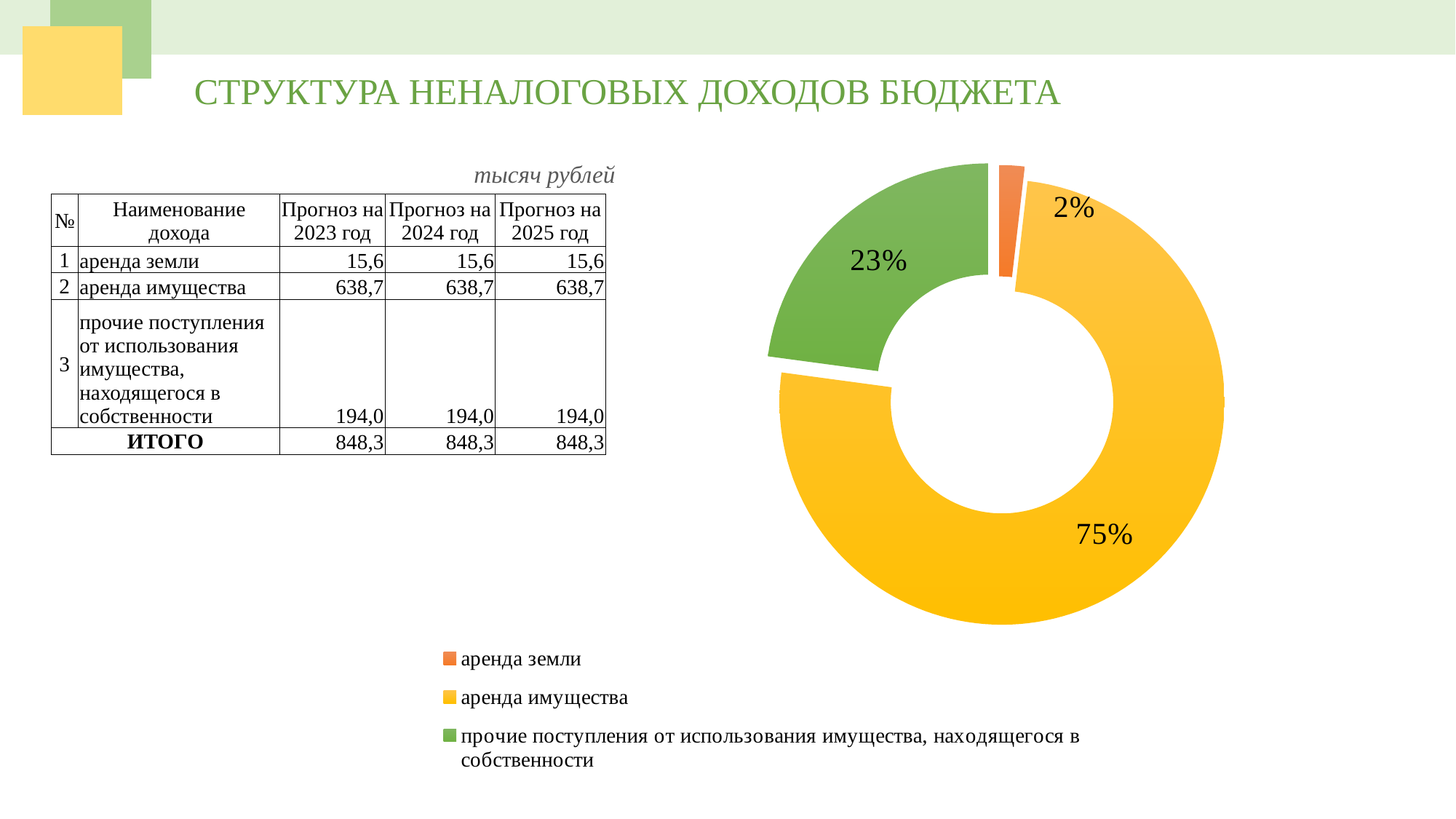
Which slice is larger: "аренда земли" or "прочие поступления от использования имущества, находящегося в собственности"? прочие поступления от использования имущества, находящегося в собственности What share of the doughnut chart does "аренда земли" account for? 2% Which category has the largest slice in the doughnut chart? аренда имущества What colour is the "аренда имущества" slice in the chart? yellow How many entries does the chart legend list? 3 Which category has the smallest slice in the doughnut chart? аренда земли What type of chart is shown on the slide? doughnut (pie) chart What share of the doughnut chart does "аренда имущества" account for? 75% What share of the doughnut chart does "прочие поступления от использования имущества, находящегося в собственности" account for? 23% By how many percentage points does the "аренда имущества" slice exceed the "прочие поступления" slice? 52 What colour is the "аренда земли" slice in the chart? orange How many slices does the doughnut chart have? 3